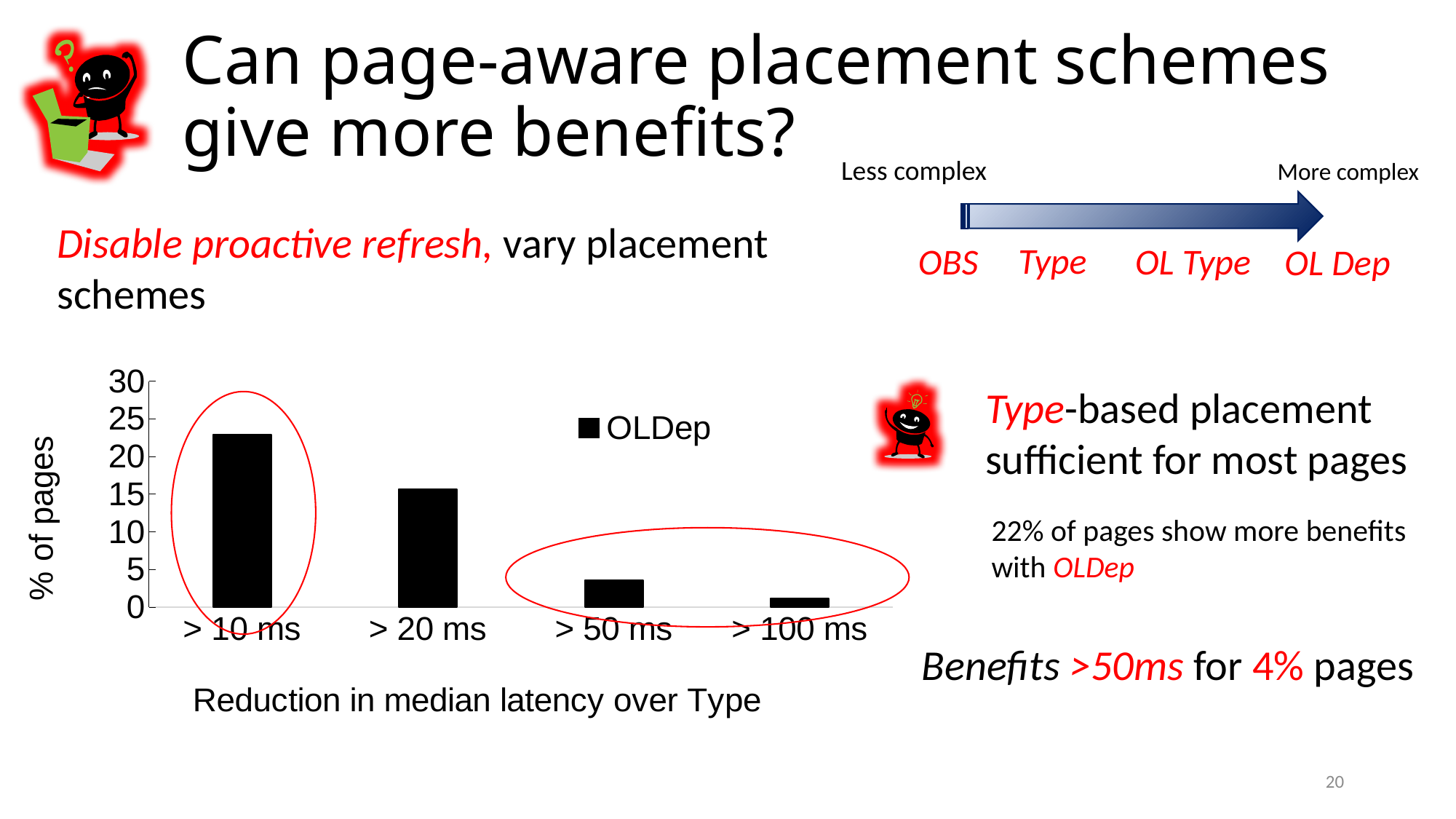
Do the values rise or fall moving left to right along the x axis? fall Is the value for > 20 ms greater or less than 20? less How many categories are plotted on the x axis of the chart? 4 Which is larger, the value for > 10 ms or the value for > 20 ms? > 10 ms Is the value for > 10 ms greater or less than 20? greater How many series does the chart's legend list? 1 What kind of chart is shown on the slide? bar chart What series name is shown in the chart's legend? OLDep Which category has the highest value in the chart? > 10 ms What is the label on the chart's y axis? % of pages Which category has the lowest value in the chart? > 100 ms Is the value for > 50 ms greater or less than 5? less